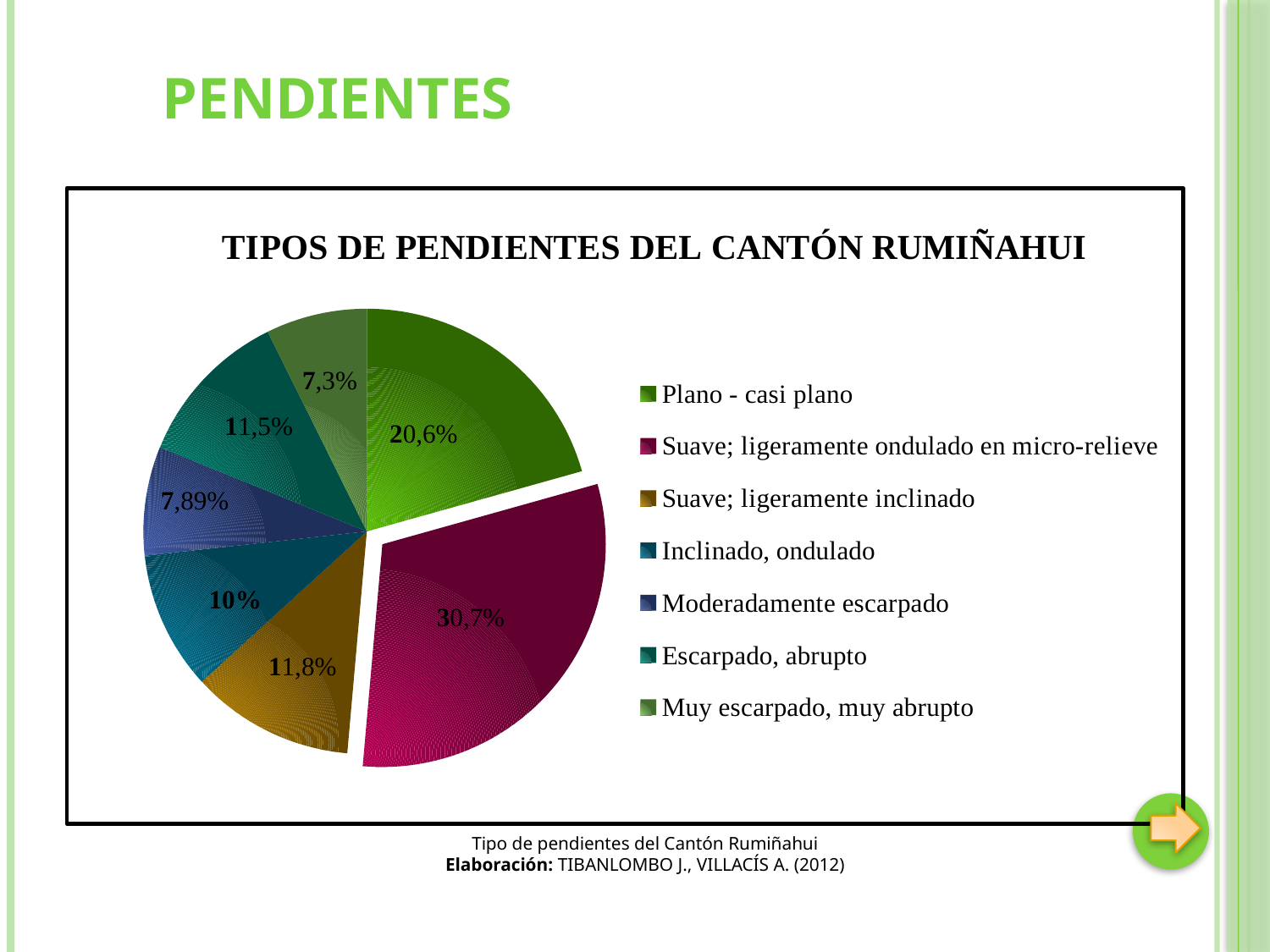
What percentage is shown for 'Plano - casi plano'? 20,6% What percentage is shown for 'Moderadamente escarpado'? 7,89% What percentage is shown for 'Muy escarpado, muy abrupto'? 7,3% Which category has the smallest share of the pie? Muy escarpado, muy abrupto What percentage is shown for 'Suave; ligeramente inclinado'? 11,8% How many categories does the legend list? 7 What type of chart is shown on the slide? pie chart What is the title of the chart? TIPOS DE PENDIENTES DEL CANTÓN RUMIÑAHUI Which is larger, the share for 'Escarpado, abrupto' or the share for 'Inclinado, ondulado'? Escarpado, abrupto What is the difference in percentage points between 'Suave; ligeramente ondulado en micro-relieve' and 'Plano - casi plano'? 10,1 What percentage is shown for 'Suave; ligeramente ondulado en micro-relieve'? 30,7% Which category has the largest share of the pie? Suave; ligeramente ondulado en micro-relieve